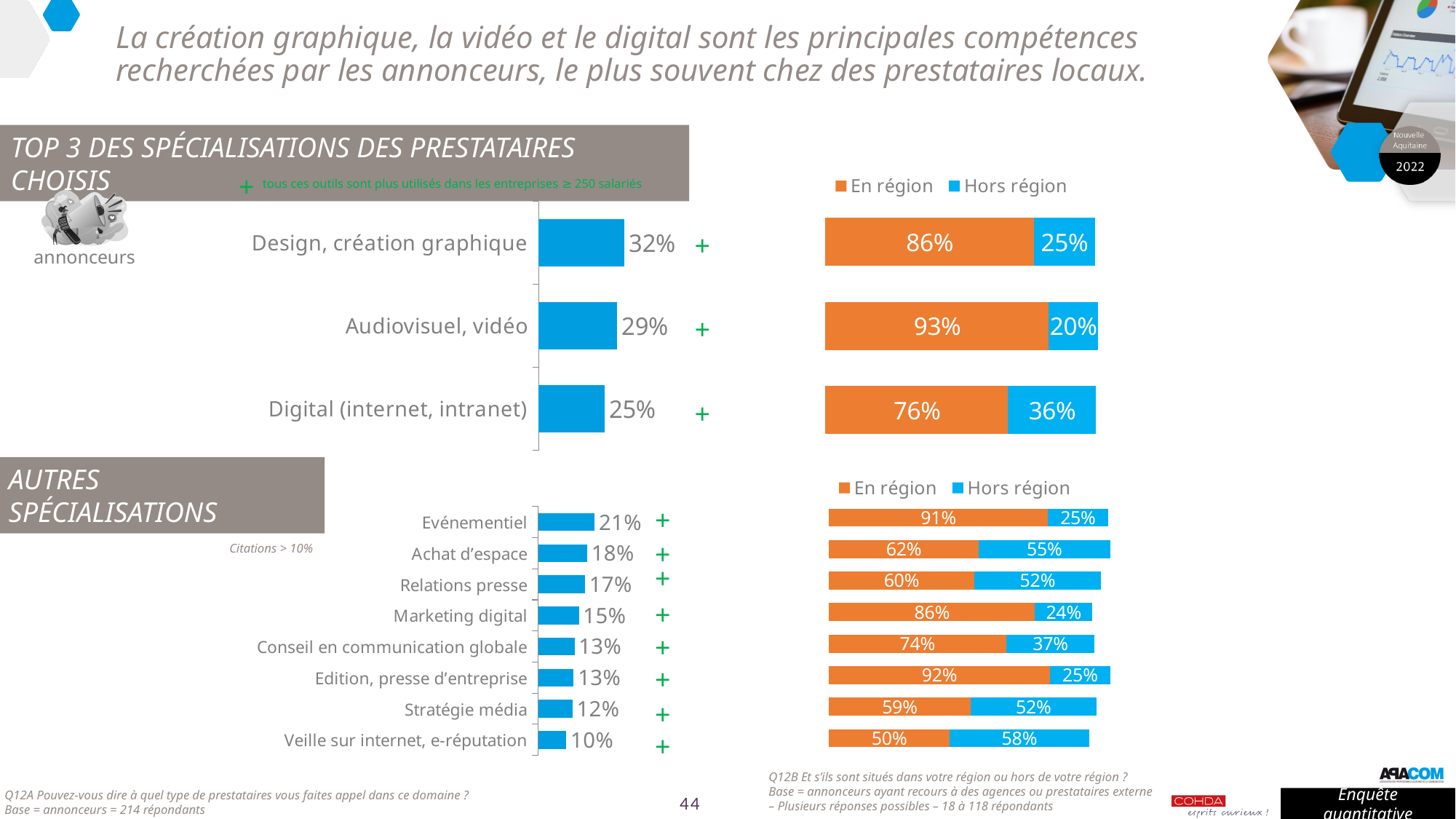
In the top-right 'En région / Hors région' chart, what is the 'Hors région' value for 'Digital (internet, intranet)'? 36% How many series does the legend of the top-right 'En région / Hors région' chart list? 2 In the 'AUTRES SPÉCIALISATIONS' bar chart on the bottom left, what is the value for 'Relations presse'? 17% In the top-right 'En région / Hors région' chart, what is the difference between the 'En région' and 'Hors région' values for 'Design, création graphique'? 61% What kind of chart is the 'TOP 3 DES SPÉCIALISATIONS DES PRESTATAIRES CHOISIS' chart on the left? Bar chart In the 'TOP 3 DES SPÉCIALISATIONS DES PRESTATAIRES CHOISIS' bar chart on the left, what is the value for 'Design, création graphique'? 32% How many categories are shown in the 'AUTRES SPÉCIALISATIONS' bar chart on the bottom left? 8 In the bottom-right 'En région / Hors région' chart, what is the 'Hors région' value for 'Achat d'espace'? 55% In the top-right 'En région / Hors région' chart, what is the 'En région' value for 'Audiovisuel, vidéo'? 93% In the bottom-right 'En région / Hors région' chart, which is larger for 'Veille sur internet, e-réputation': the 'En région' value or the 'Hors région' value? Hors région In the 'TOP 3 DES SPÉCIALISATIONS DES PRESTATAIRES CHOISIS' bar chart on the left, which category has the lowest value? Digital (internet, intranet) In the 'AUTRES SPÉCIALISATIONS' bar chart on the bottom left, which category has the highest value? Evénementiel